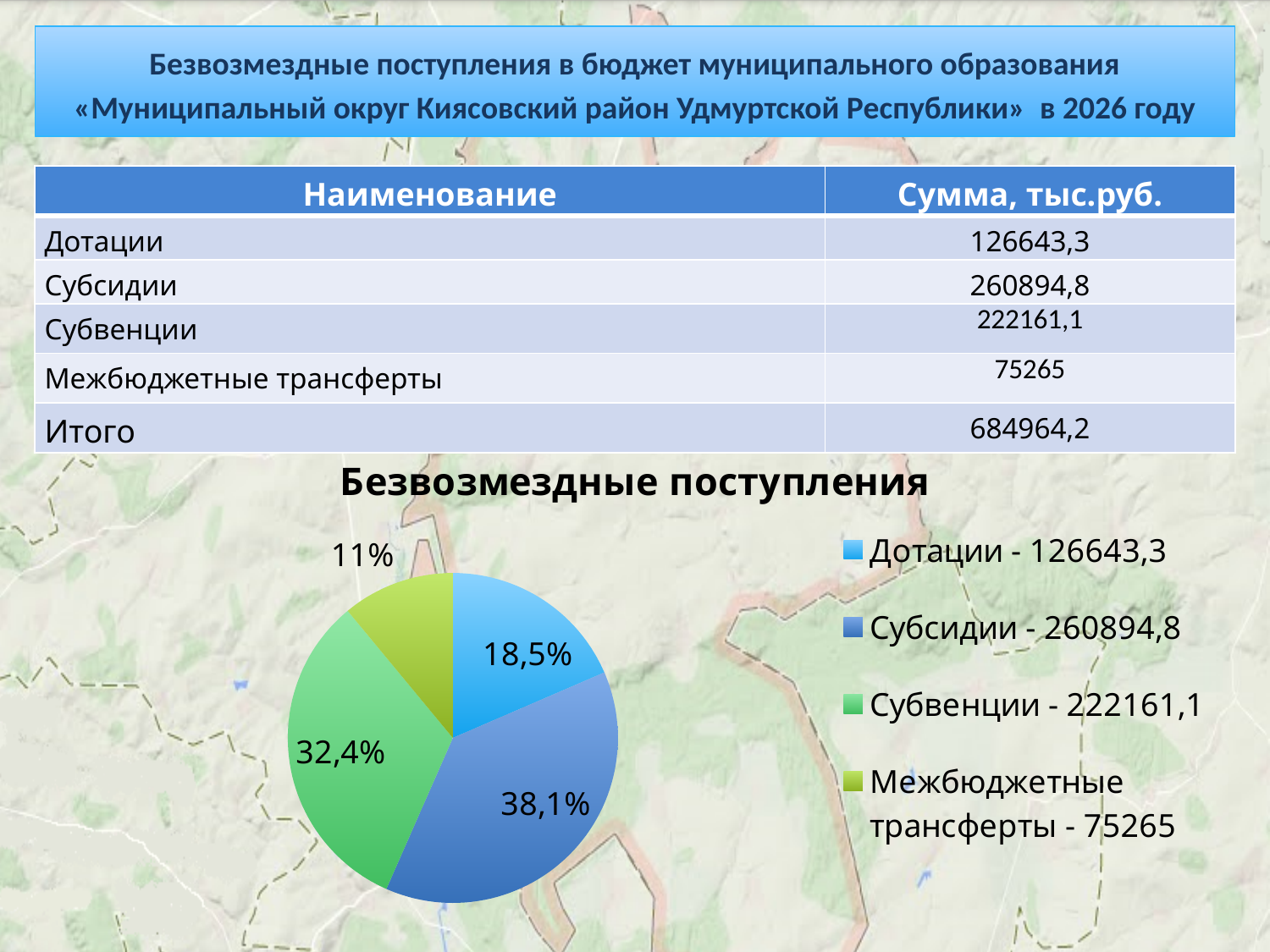
What share of the pie does Субсидии take? 38,1% How many entries does the chart legend list? 4 Which slice is larger, Субвенции or Дотации? Субвенции What value is shown in the legend for Субвенции? 222161,1 What kind of chart is shown on the slide? pie chart Which category has the smallest slice of the pie? Межбюджетные трансферты How many slices does the pie chart have? 4 What is the title of the chart? Безвозмездные поступления Which category has the largest slice of the pie? Субсидии What share of the pie does Межбюджетные трансферты take? 11% What share of the pie does Субвенции take? 32,4%